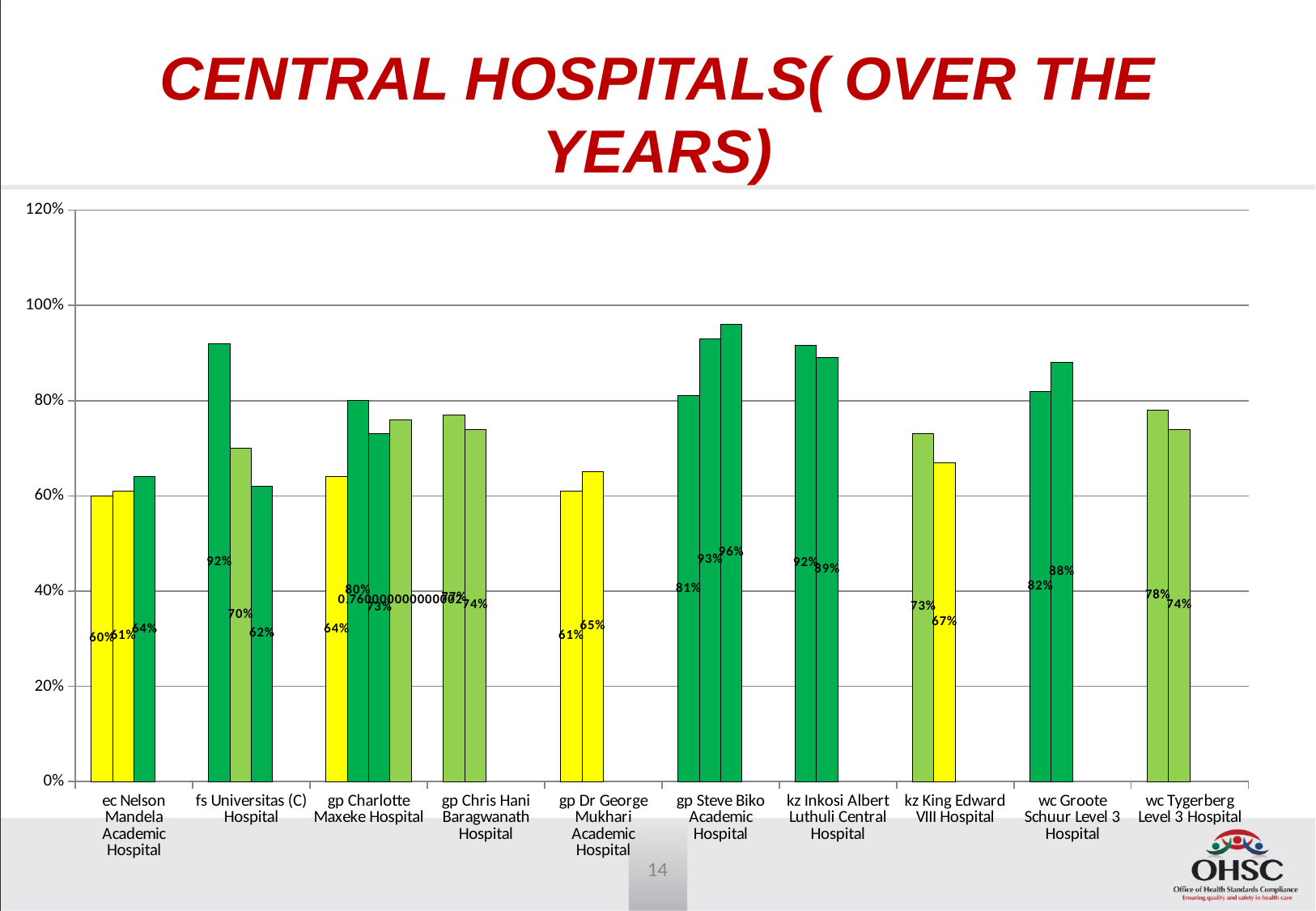
Do the three bars for ec Nelson Mandela Academic Hospital rise or fall from left to right? rise What kind of chart is shown on the slide? bar chart What is the difference between the two bars for wc Groote Schuur Level 3 Hospital? 6 percentage points Is the tallest bar for gp Dr George Mukhari Academic Hospital greater or less than 80%? less Which hospital has the highest single bar in the chart? gp Steve Biko Academic Hospital What is the title of the slide containing the chart? CENTRAL HOSPITALS( OVER THE YEARS) What is the value of the tallest bar for fs Universitas (C) Hospital? 92% What is the lowest value labelled in the chart? 60% What is the highest value labelled in the chart? 96% What are the two values labelled for wc Groote Schuur Level 3 Hospital? 82% and 88% Which is larger: the first bar for kz Inkosi Albert Luthuli Central Hospital or the first bar for kz King Edward VIII Hospital? kz Inkosi Albert Luthuli Central Hospital How many hospitals are shown along the x axis of the chart? 10